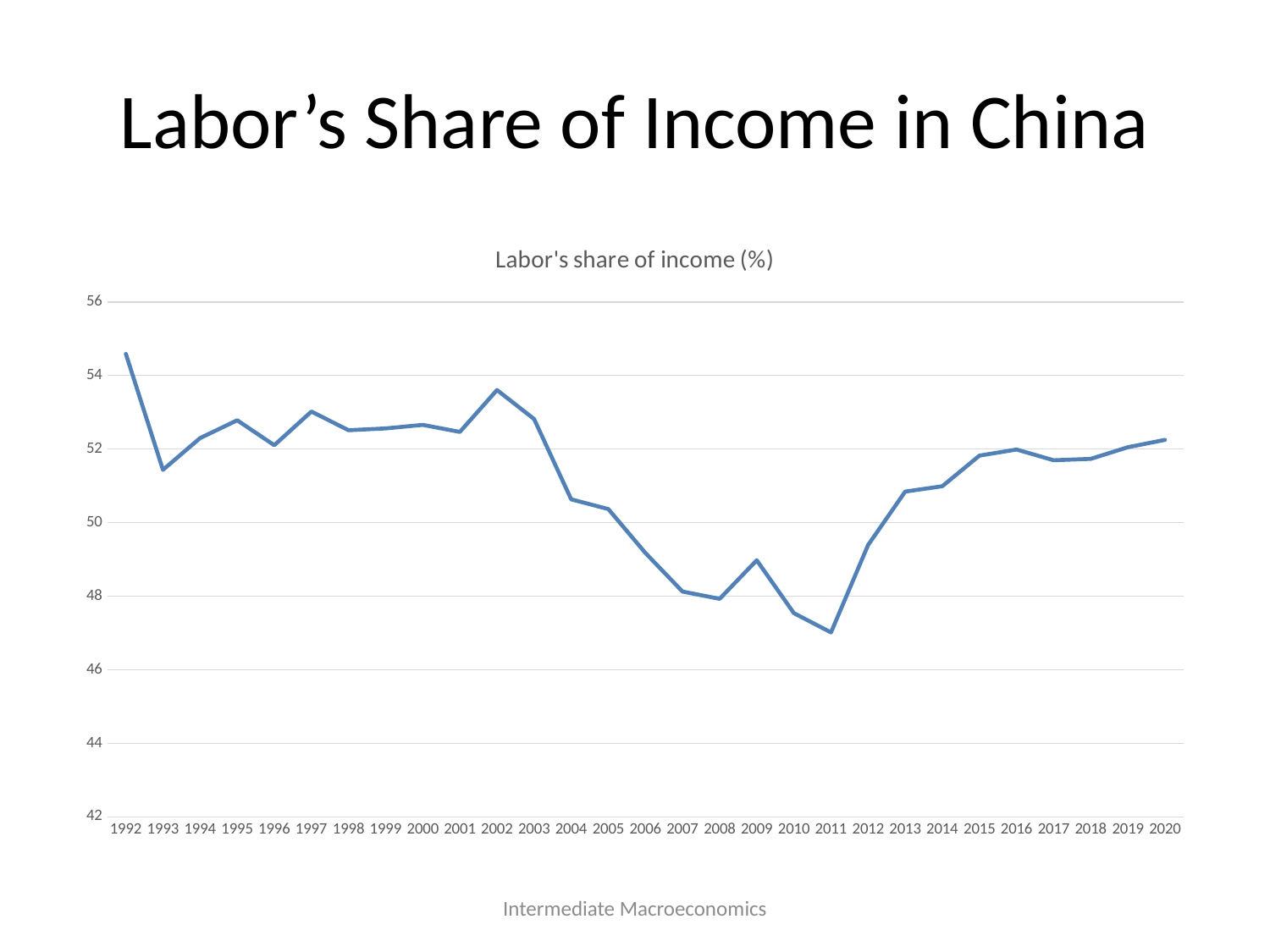
What kind of chart is shown on the slide? line chart Which year has the highest labor's share of income? 1992 Which is larger, the value for 1992 or the value for 2020? 1992 Which is larger, the value for 2009 or the value for 2010? 2009 Which year has the lowest labor's share of income? 2011 How many years are plotted along the x axis? 29 Does labor's share of income rise or fall from 2011 to 2020? rise Is the value for 2011 greater or less than 48? less Is the value for 1992 greater or less than 54? greater Is the value for 1993 greater or less than 52? less What is the title of the chart? Labor's share of income (%)